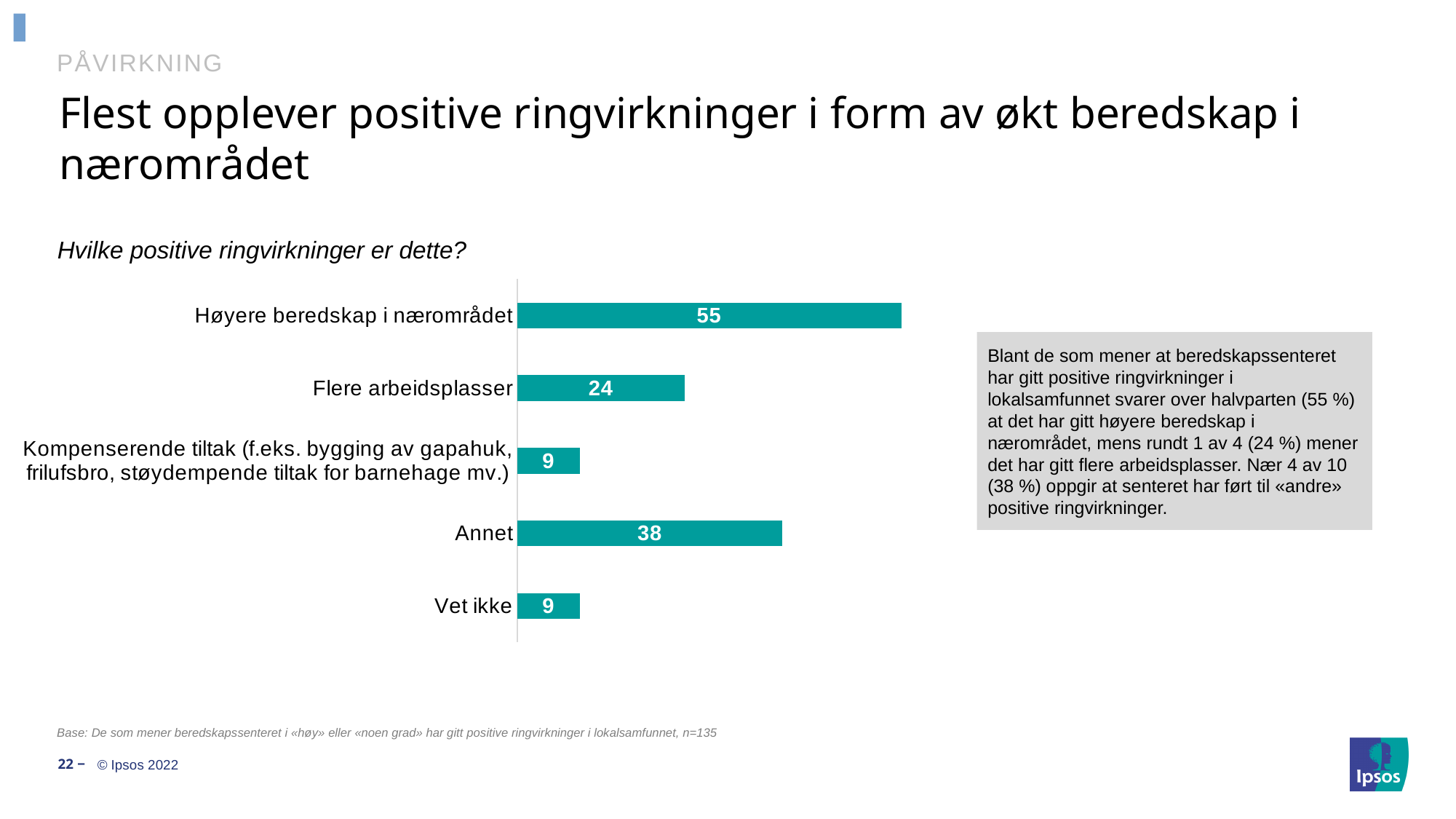
What is the value for "Annet"? 38 What kind of chart is shown on the slide? Bar chart Which is larger, the value for "Annet" or the value for "Flere arbeidsplasser"? Annet What is the value for "Høyere beredskap i nærområdet"? 55 What is the value for "Vet ikke"? 9 What is the value for "Kompenserende tiltak (f.eks. bygging av gapahuk, frilufsbro, støydempende tiltak for barnehage mv.)"? 9 What question is the chart based on, as shown above it? Hvilke positive ringvirkninger er dette? What is the difference between the values for "Høyere beredskap i nærområdet" and "Annet"? 17 What is the difference between the values for "Flere arbeidsplasser" and "Vet ikke"? 15 How many categories are shown in the chart? 5 What is the value for "Flere arbeidsplasser"? 24 Which category has the highest value? Høyere beredskap i nærområdet